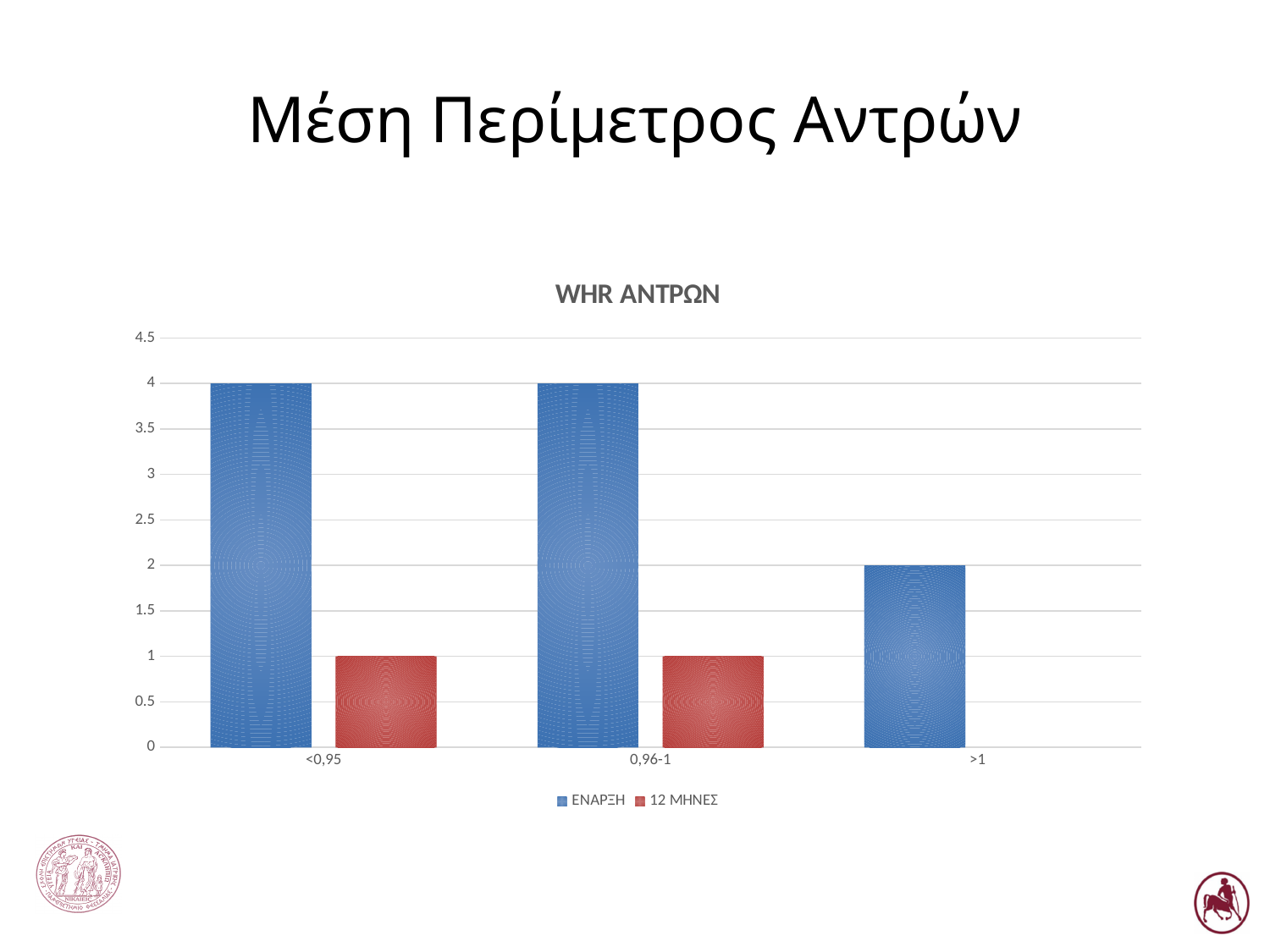
What kind of chart is shown on the slide? bar chart What is the difference between the ΕΝΑΡΞΗ and 12 ΜΗΝΕΣ values for the category <0,95? 3 What is the ΕΝΑΡΞΗ value for the category >1? 2 Which is larger for the category 0,96-1: the ΕΝΑΡΞΗ value or the 12 ΜΗΝΕΣ value? ΕΝΑΡΞΗ How many series does the legend list? 2 Which colour represents the 12 ΜΗΝΕΣ series? red What is the 12 ΜΗΝΕΣ value for the category 0,96-1? 1 How many categories are shown on the x axis? 3 What is the ΕΝΑΡΞΗ value for the category <0,95? 4 What is the title of the chart? WHR ΑΝΤΡΩΝ Is the ΕΝΑΡΞΗ value for the category >1 greater or less than 3? less Which category has the lowest ΕΝΑΡΞΗ value? >1